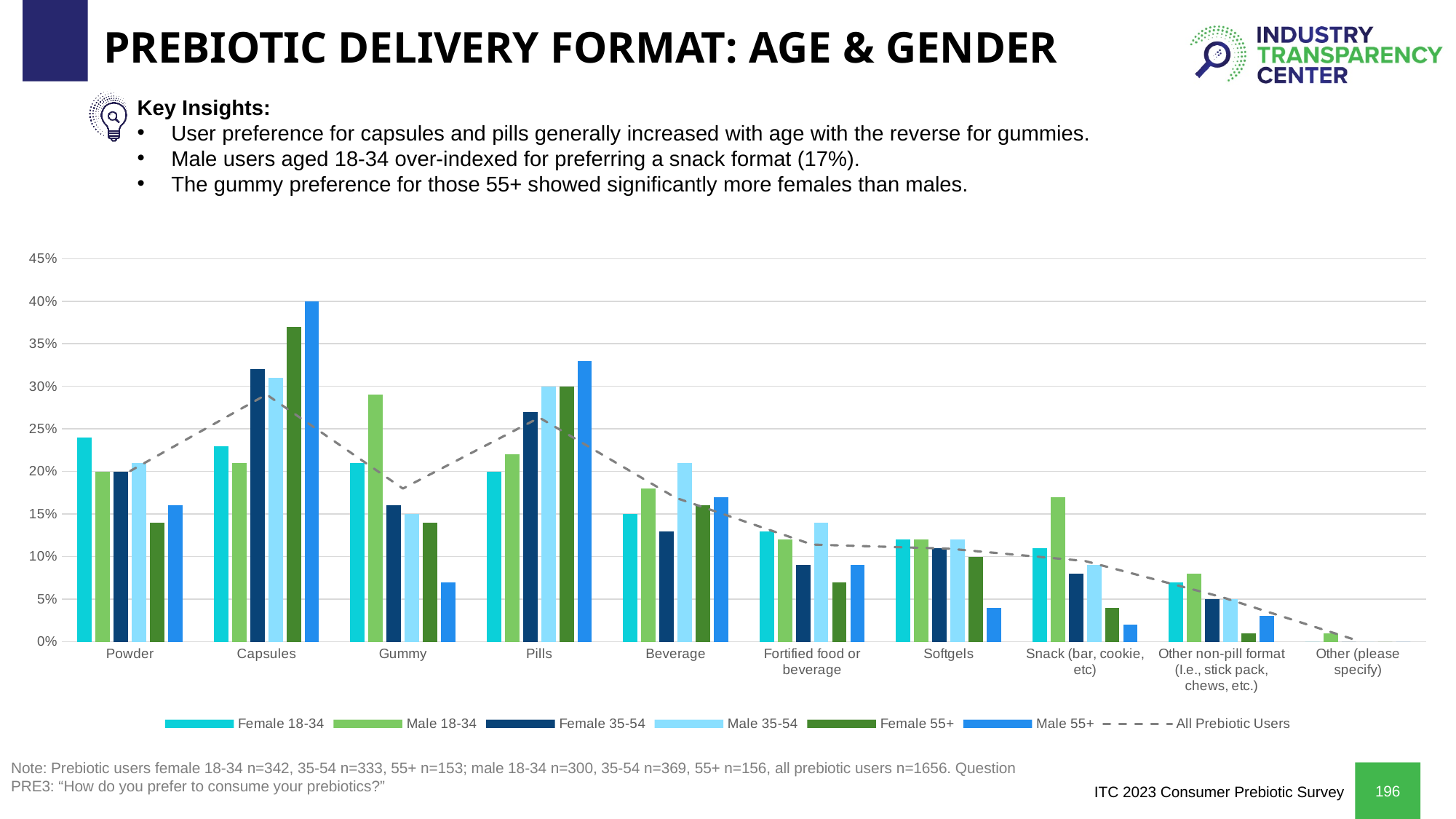
Is the Male 55+ value for Gummy greater or less than 10%? less Is the Female 18-34 value for Powder greater or less than 20%? greater For Gummy, which is larger: the Female 18-34 value or the Male 18-34 value? Male 18-34 What kind of chart is shown on the slide? bar and line chart What does the dashed grey line in the chart represent? All Prebiotic Users Is the Male 18-34 value for Gummy greater or less than 25%? greater How many delivery format categories are shown on the x axis? 10 How many series does the legend list? 7 What is the Male 18-34 value for Snack (bar, cookie, etc)? 17% For Capsules, which is larger: the Female 55+ value or the Male 55+ value? Male 55+ What is the Male 55+ value for Capsules? 40% Which delivery format has the highest value for Male 55+? Capsules